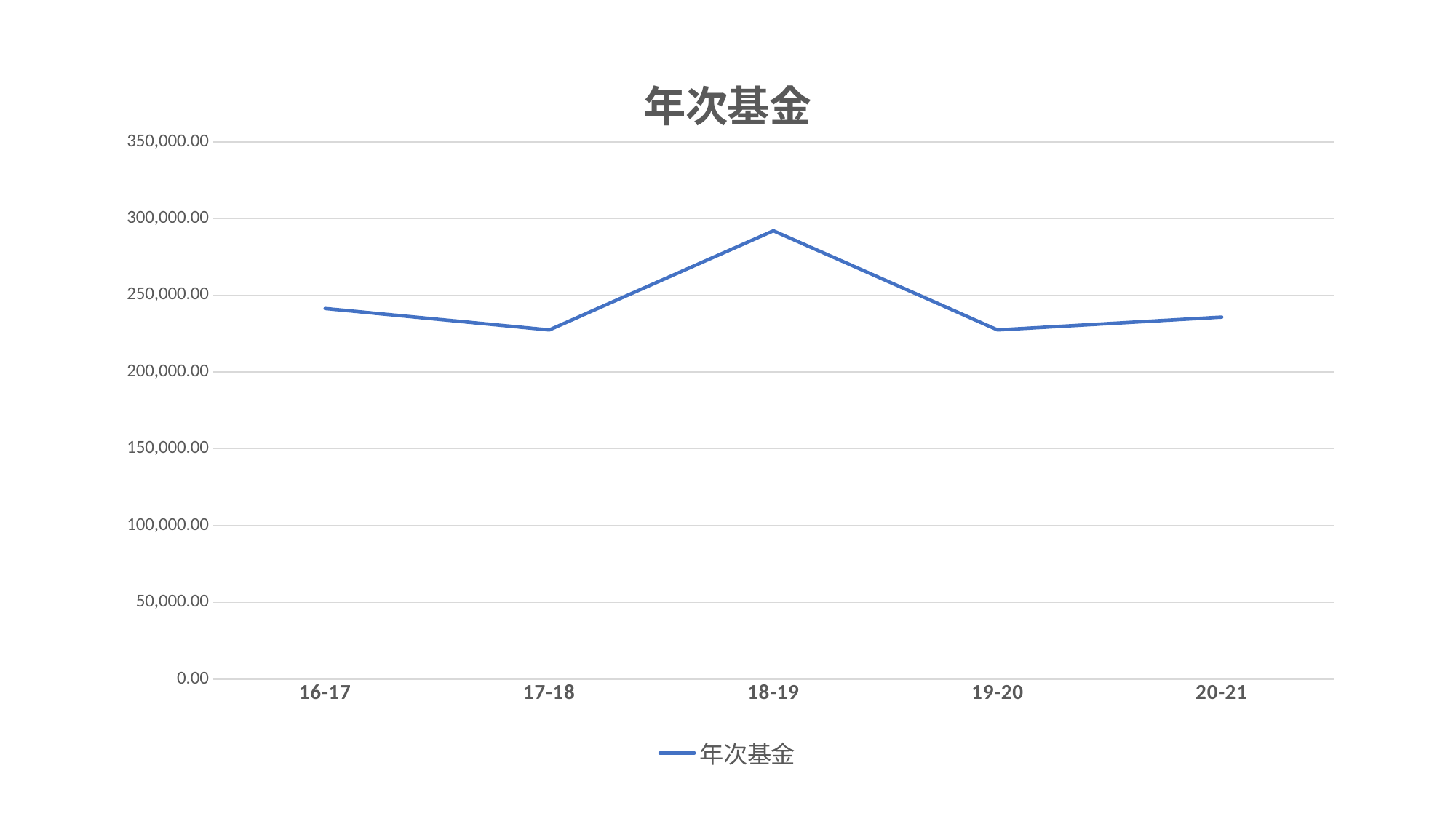
Is the value for 20-21 greater or less than 250,000.00? less How many points are plotted along the x axis? 5 Does the value rise or fall from 18-19 to 19-20? fall How many series does the legend list? 1 What kind of chart is shown on the slide? line chart Is the value for 18-19 greater or less than 300,000.00? less Which is larger, the value for 18-19 or the value for 20-21? 18-19 What is the title of the chart? 年次基金 Is the value for 18-19 greater or less than 250,000.00? greater Does the value rise or fall from 17-18 to 18-19? rise Which year has the highest value for 年次基金? 18-19